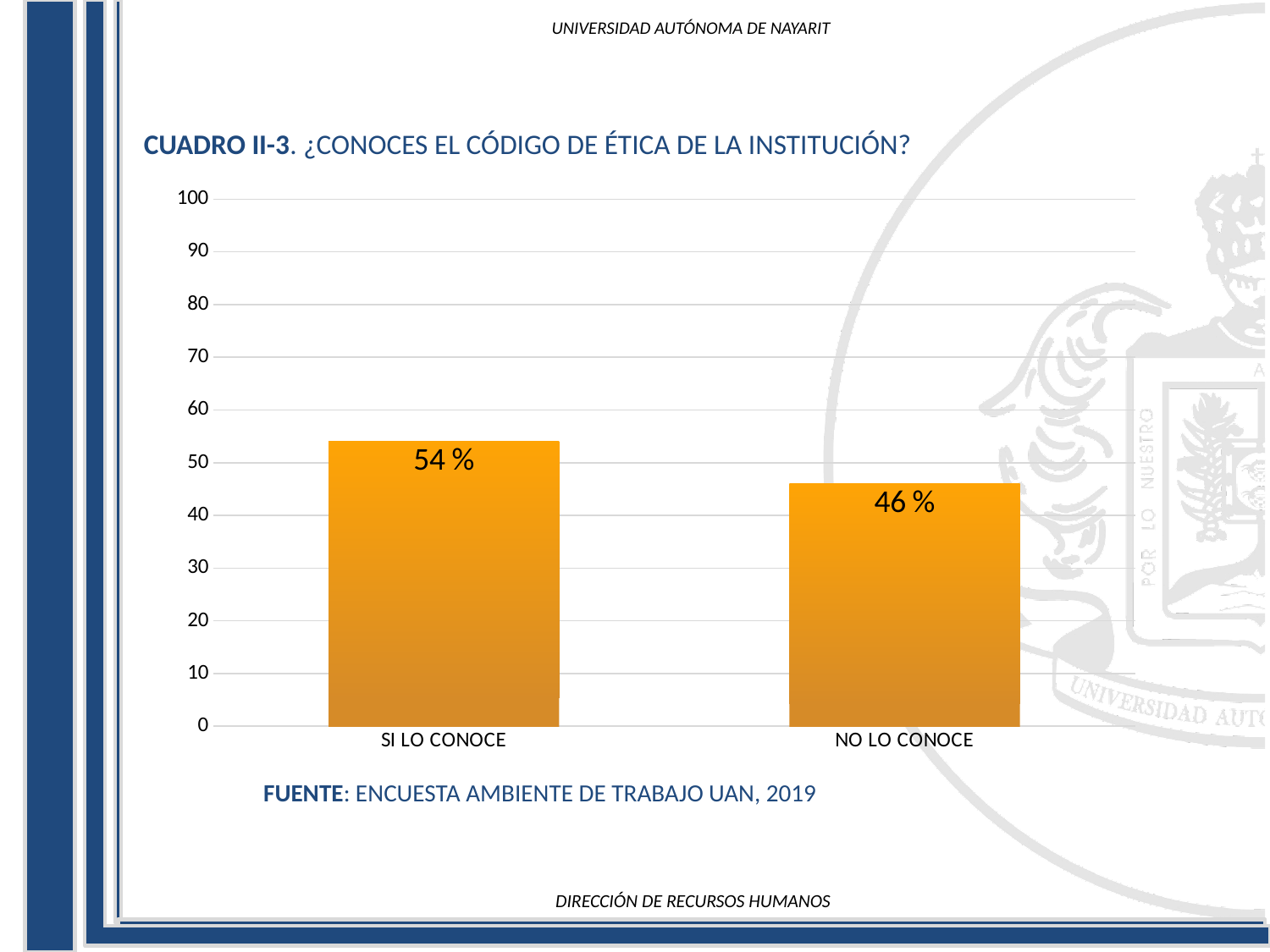
What kind of chart is shown on the slide? bar chart What is the title of the chart? CUADRO II-3. ¿CONOCES EL CÓDIGO DE ÉTICA DE LA INSTITUCIÓN? What is the difference between the values for SI LO CONOCE and NO LO CONOCE? 8 % Is the value for SI LO CONOCE greater or less than 50? greater Which category has the lowest value? NO LO CONOCE Which is larger, the value for SI LO CONOCE or the value for NO LO CONOCE? SI LO CONOCE What is the value for NO LO CONOCE? 46 % What is the source cited below the chart? ENCUESTA AMBIENTE DE TRABAJO UAN, 2019 Is the value for NO LO CONOCE greater or less than 50? less What is the value for SI LO CONOCE? 54 % Which category has the highest value? SI LO CONOCE How many categories are shown in the chart? 2